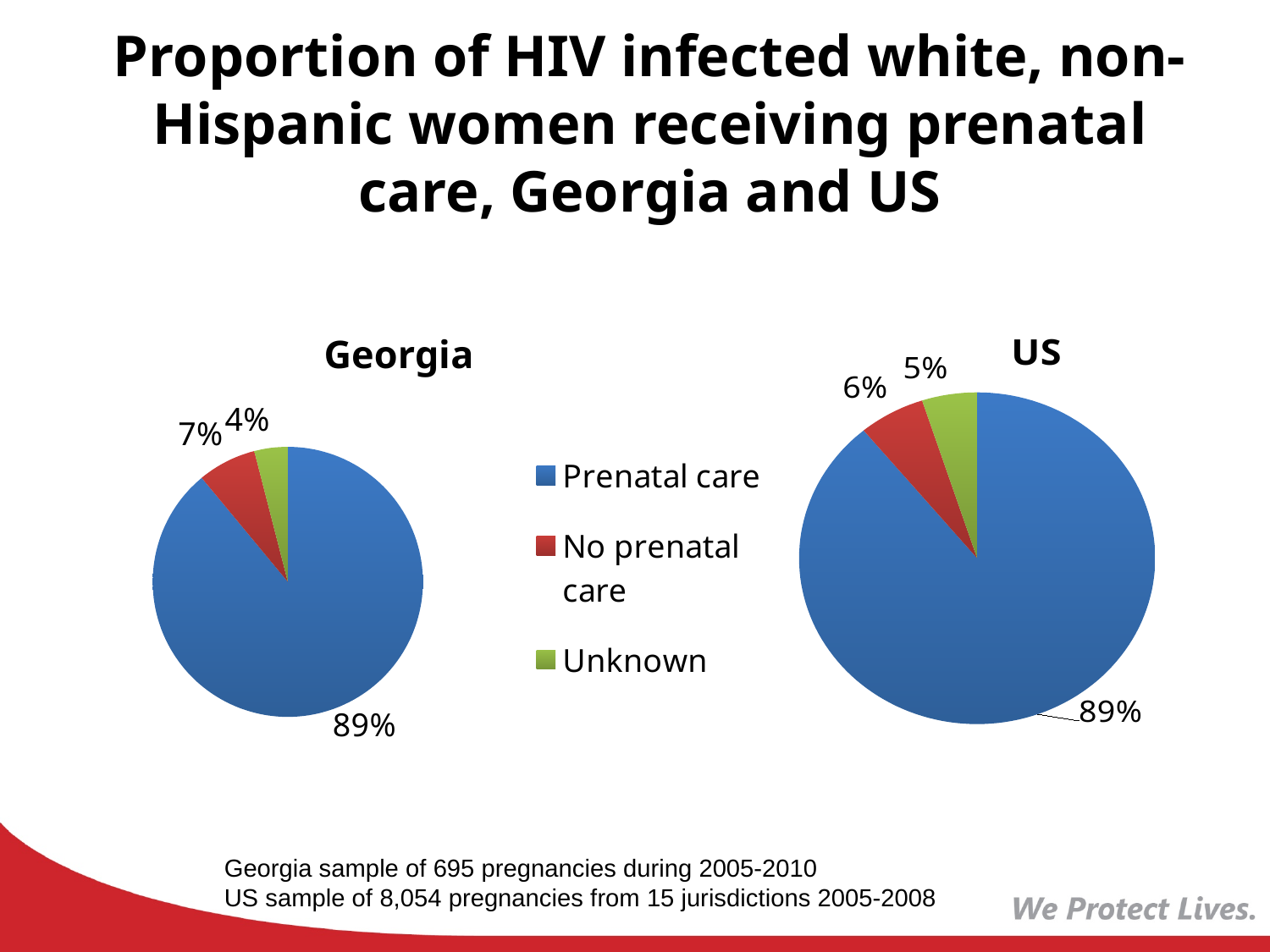
In the US pie chart, what percentage of women received no prenatal care? 6% In the Georgia pie chart, what percentage of women received prenatal care? 89% Which is larger: the Unknown share in the Georgia chart or the Unknown share in the US chart? US What is the difference between the No prenatal care percentage in Georgia and in the US? 1% In the US pie chart, which category has the smallest slice? Unknown In the Georgia pie chart, what percentage is labelled Unknown? 4% In the US pie chart, what percentage is labelled Unknown? 5% In the Georgia pie chart, which category has the largest slice? Prenatal care What type of chart is used for the Georgia and US data? Pie chart How many categories does the legend list? 3 In the Georgia pie chart, what percentage of women received no prenatal care? 7% In the US pie chart, what percentage of women received prenatal care? 89%